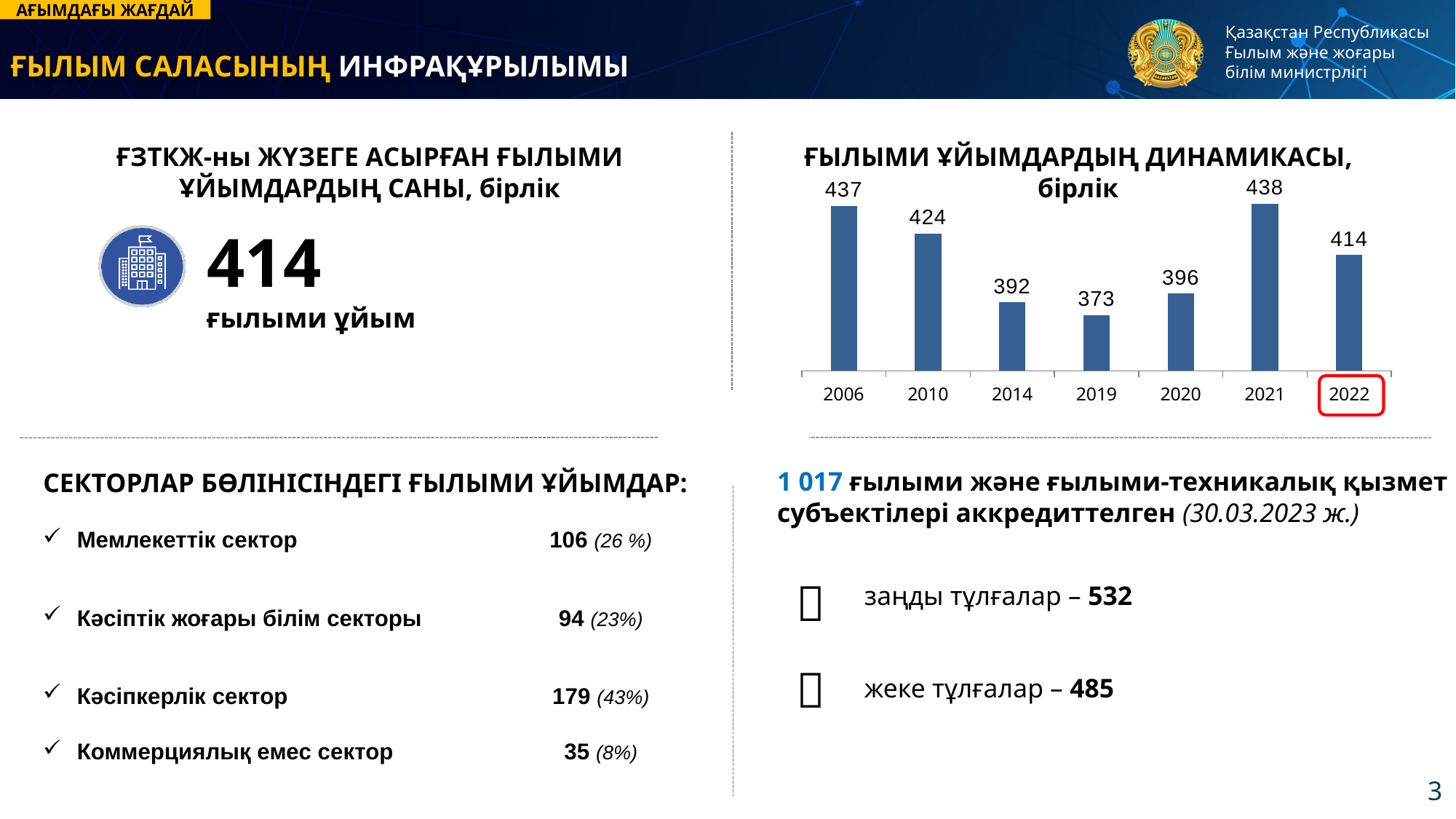
What is the value for 2022 in the chart? 414 What is the value for 2014 in the chart? 392 What kind of chart is shown on the slide? bar chart What is the difference between the values for 2021 and 2022? 24 Which is larger, the value for 2010 or the value for 2020? 2010 How many years are shown in the chart? 7 Which year has the highest value in the chart? 2021 Do the values rise or fall from 2019 to 2021? rise What is the value for 2006 in the chart? 437 What is the difference between the values for 2006 and 2019? 64 Which year has the lowest value in the chart? 2019 What is the value for 2019 in the chart? 373